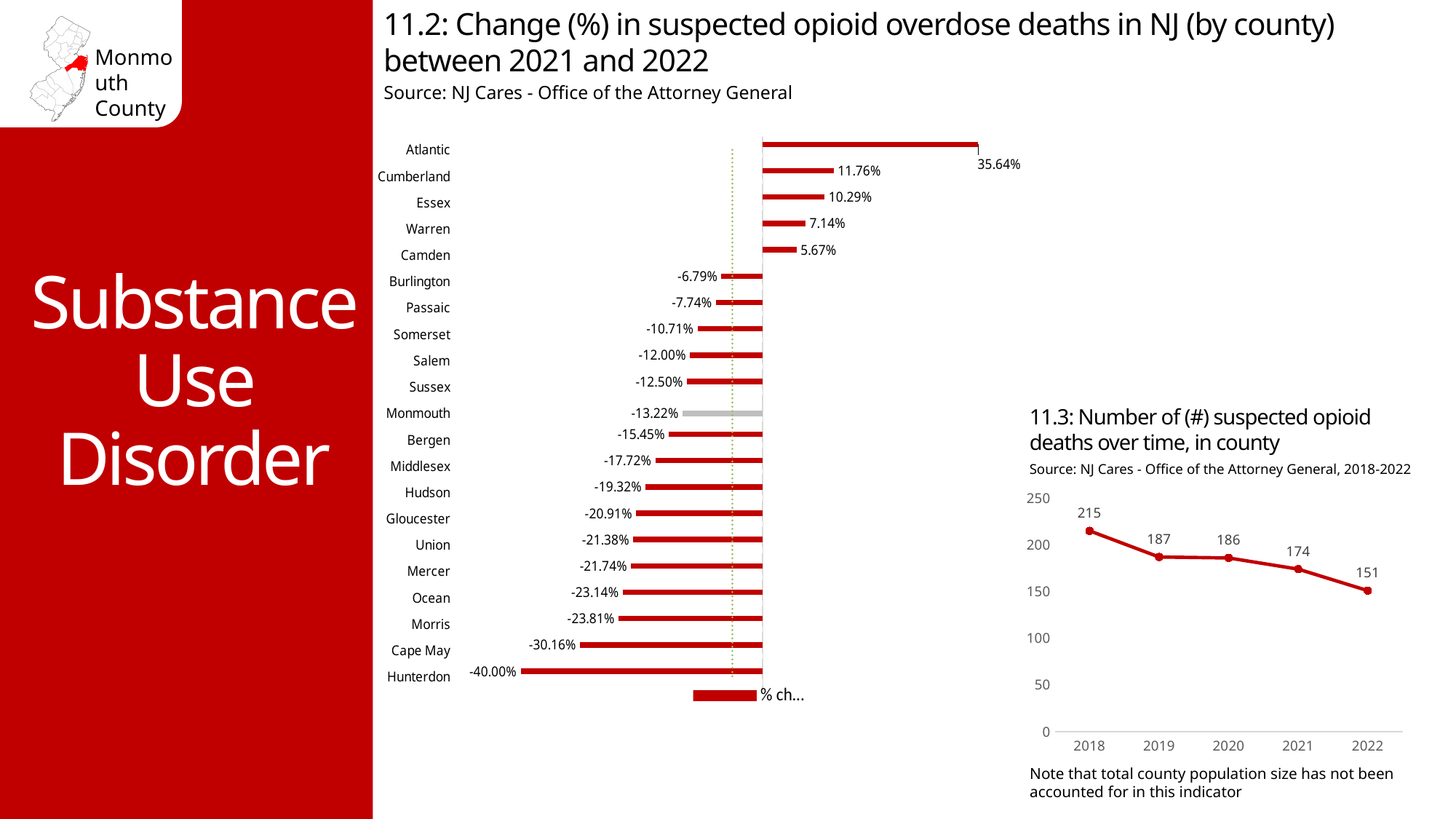
In chart 11.3 (Number of suspected opioid deaths over time), what is the value for 2022? 151 In chart 11.2, which county has the lowest percentage change? Hunterdon What kind of chart is chart 11.2? Bar chart In chart 11.2 (Change in suspected opioid overdose deaths by county), what is the value for Monmouth? -13.22% In chart 11.2, how many counties are shown? 21 In chart 11.2, what is the difference between the values for Atlantic and Cumberland? 23.88 percentage points In chart 11.3, do the values rise or fall from 2018 to 2022? Fall In chart 11.2, which is larger, the value for Cumberland or the value for Essex? Cumberland In chart 11.2, what is the value for Cape May? -30.16% In chart 11.2, which county has the highest percentage change? Atlantic In chart 11.3, how many data points are plotted? 5 In chart 11.3, what is the difference between the values for 2018 and 2022? 64